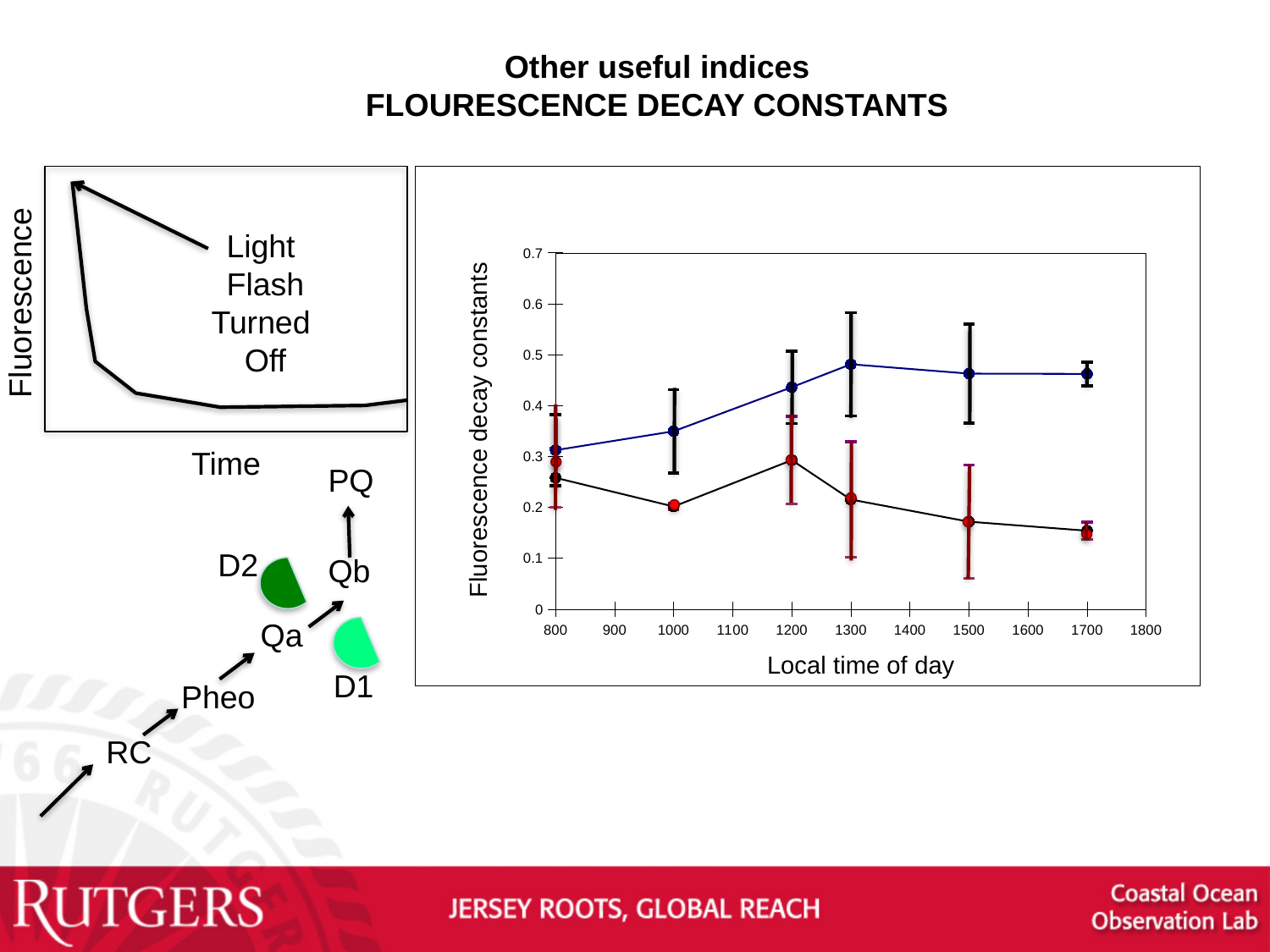
On the right-hand chart, is the value of the blue series at 1300 greater or less than 0.4? greater On the right-hand chart, is the value of the blue series at 800 greater or less than 0.4? less On the right-hand chart, does the black series generally rise or fall between 1200 and 1700? fall On the right-hand chart, how many time points are plotted for the blue series? 6 What kind of chart is the right-hand chart with the axis 'Local time of day'? line chart On the right-hand chart, at which local time of day does the blue series reach its highest value? 1300 On the right-hand chart, which series has the higher value at 1500, the blue series or the black series? the blue series On the right-hand chart, is the value of the black series at 1700 greater or less than 0.2? less On the right-hand chart, does the blue series generally rise or fall between 800 and 1300? rise On the right-hand chart, what is the label of the x axis? Local time of day On the right-hand chart, what is the label of the y axis? Fluorescence decay constants